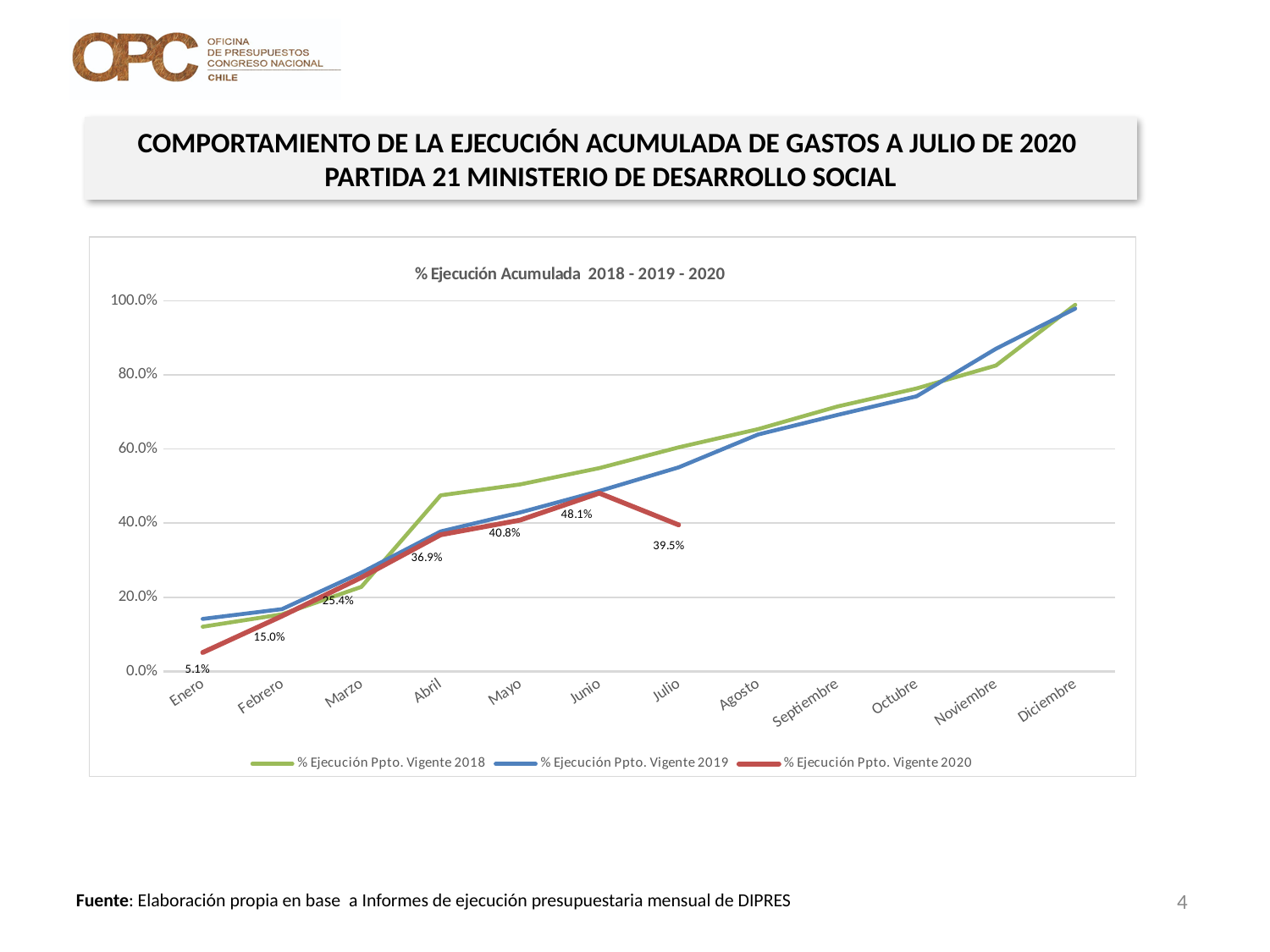
Is the value for Enero in the % Ejecución Ppto. Vigente 2019 series greater or less than 20.0%? less Is the value for Abril in the % Ejecución Ppto. Vigente 2018 series greater or less than 40.0%? greater How many series does the chart legend list? 3 What is the value for Julio in the % Ejecución Ppto. Vigente 2020 series? 39.5% How many months are shown on the x axis of the chart? 12 What is the value for Abril in the % Ejecución Ppto. Vigente 2020 series? 36.9% In the % Ejecución Ppto. Vigente 2020 series, which is larger, the value for Junio or the value for Julio? Junio Which month has the highest value in the % Ejecución Ppto. Vigente 2020 series? Junio Which month has the lowest value in the % Ejecución Ppto. Vigente 2020 series? Enero What is the value for Enero in the % Ejecución Ppto. Vigente 2020 series? 5.1% What is the difference between the Junio and Mayo values in the % Ejecución Ppto. Vigente 2020 series? 7.3 percentage points What kind of chart is shown on the slide? Line chart